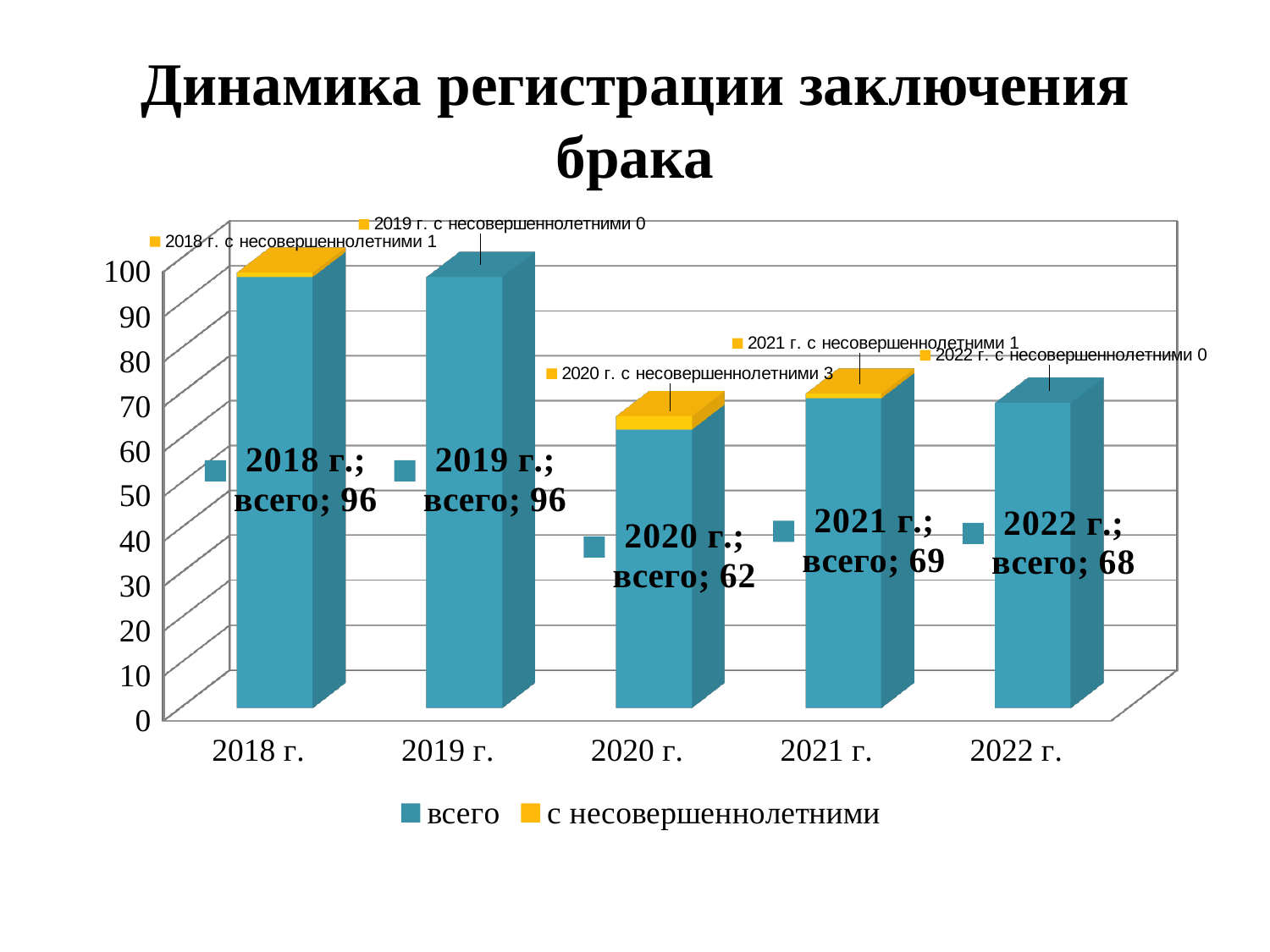
How many series does the legend list? 2 What is the value of "с несовершеннолетними" for 2022 г.? 0 How many years are shown on the x axis? 5 What is the value of "с несовершеннолетними" for 2020 г.? 3 Which year has the lowest value of "всего"? 2020 г. What is the value of "всего" for 2020 г.? 62 Which is larger, the "всего" value for 2021 г. or for 2022 г.? 2021 г. What kind of chart is shown on the slide? Stacked bar chart What is the value of "всего" for 2018 г.? 96 What is the difference between the "всего" values for 2019 г. and 2020 г.? 34 What is the total of the stacked bar for 2020 г.? 65 Which year has the highest value of "с несовершеннолетними"? 2020 г.